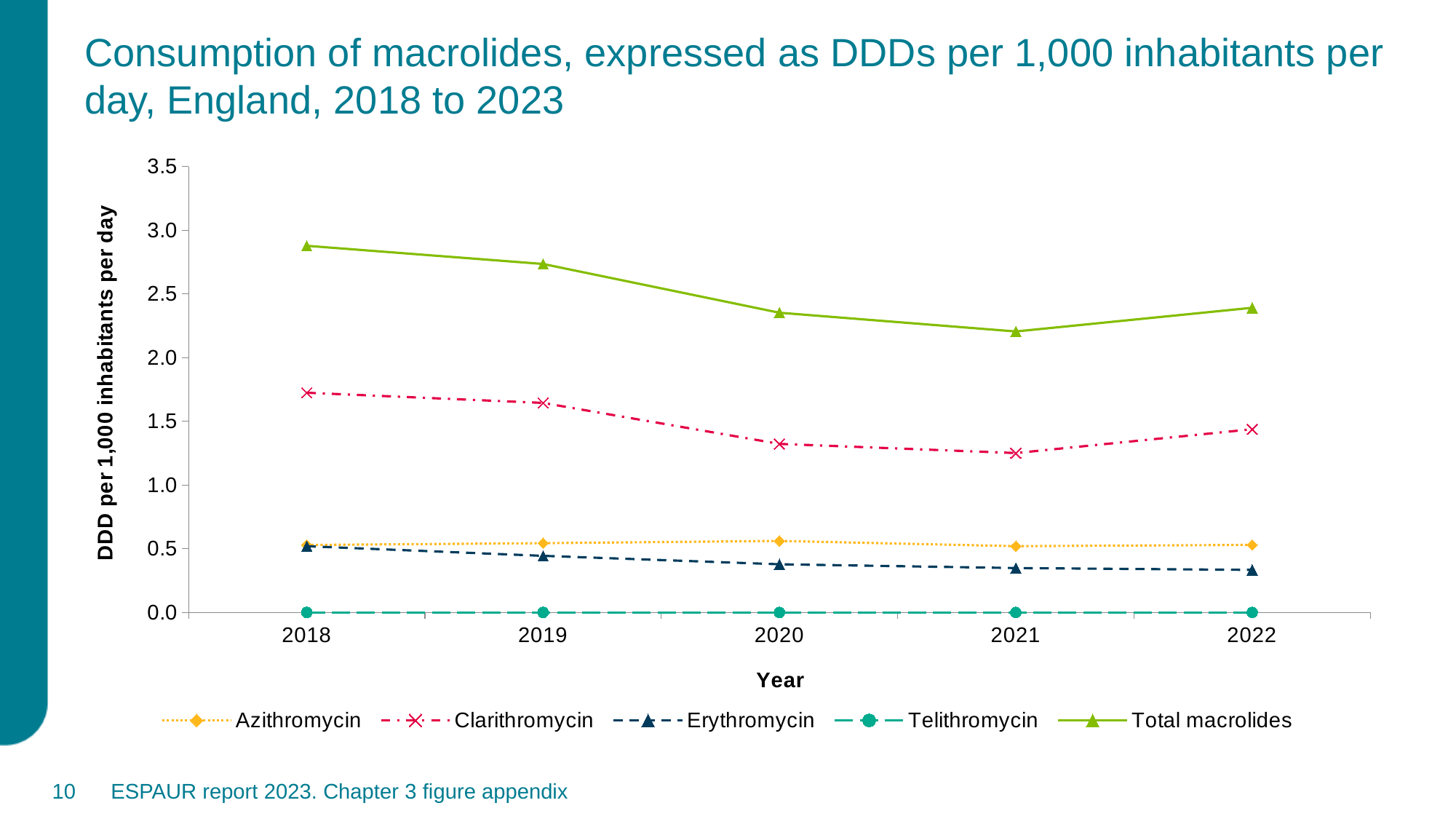
What kind of chart is shown on the slide? Line chart Is the value for Erythromycin in 2022 greater or less than 0.5? less In which year is the value for Total macrolides highest? 2018 How many years are plotted along the x axis? 5 In which year is the value for Total macrolides lowest? 2021 How many series does the legend list? 5 Which is larger in 2019, the value for Clarithromycin or the value for Azithromycin? Clarithromycin Is the value for Total macrolides in 2018 greater or less than 2.5? greater Is the value for Clarithromycin in 2020 greater or less than 1.5? less Does the value for Erythromycin rise or fall from 2018 to 2022? Fall In which year is the value for Clarithromycin lowest? 2021